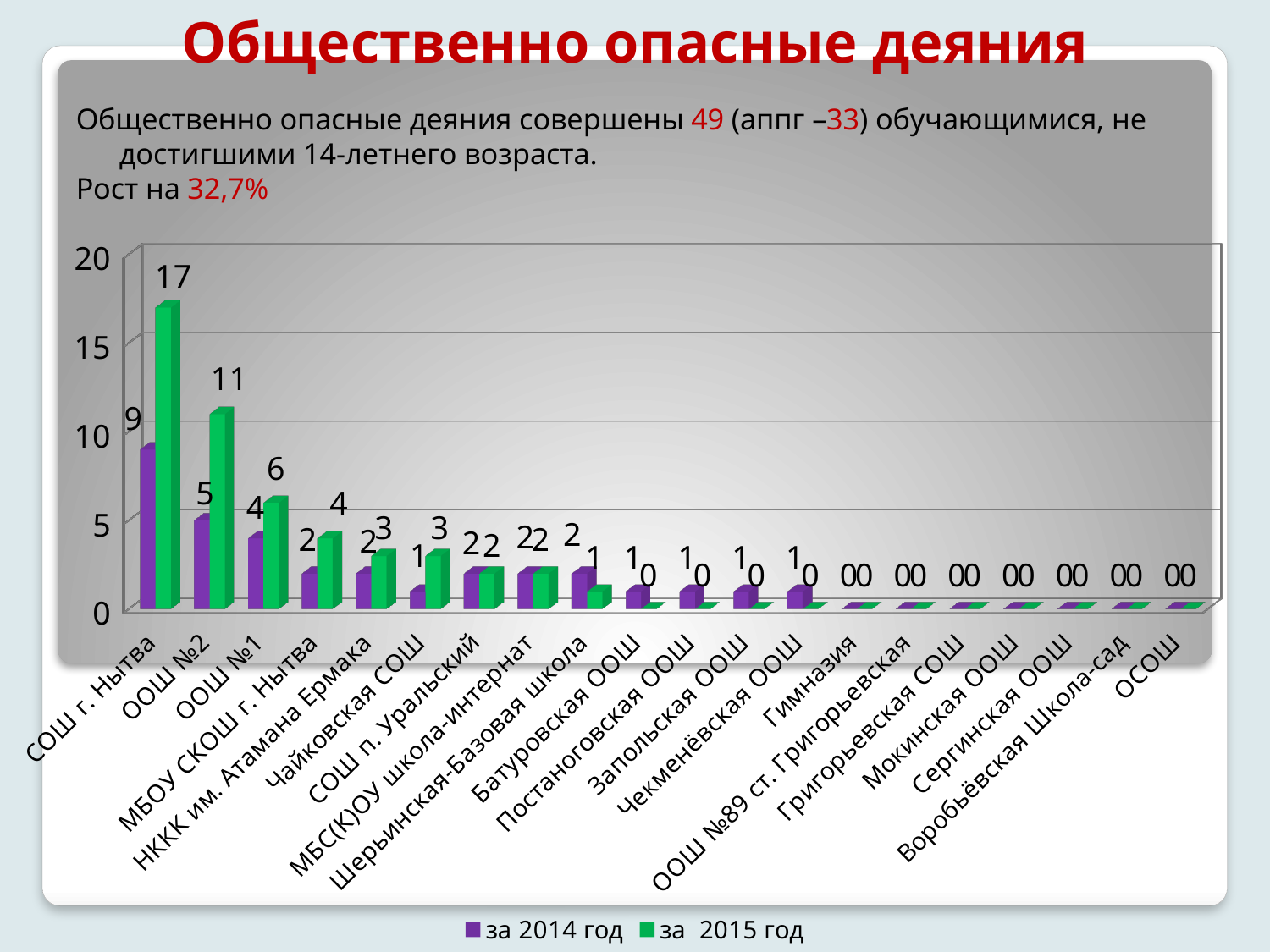
What type of chart is shown on the slide? bar chart How many series does the legend list? 2 What is the value for ООШ №2 in the series 'за 2014 год'? 5 What is the value for СОШ г. Нытва in the series 'за 2015 год'? 17 How many categories are shown on the x axis? 20 What is the value for Батуровская ООШ in the series 'за 2015 год'? 0 What is the difference between the 2015 and 2014 values for ООШ №2? 6 What is the difference between the 2015 and 2014 values for СОШ г. Нытва? 8 Is the value for СОШ г. Нытва in the series 'за 2015 год' greater or less than 15? greater What is the value for ООШ №1 in the series 'за 2015 год'? 6 Which is larger for Шерьинская-Базовая школа: the value for 'за 2014 год' or 'за 2015 год'? за 2014 год Which category has the highest value in the series 'за 2015 год'? СОШ г. Нытва